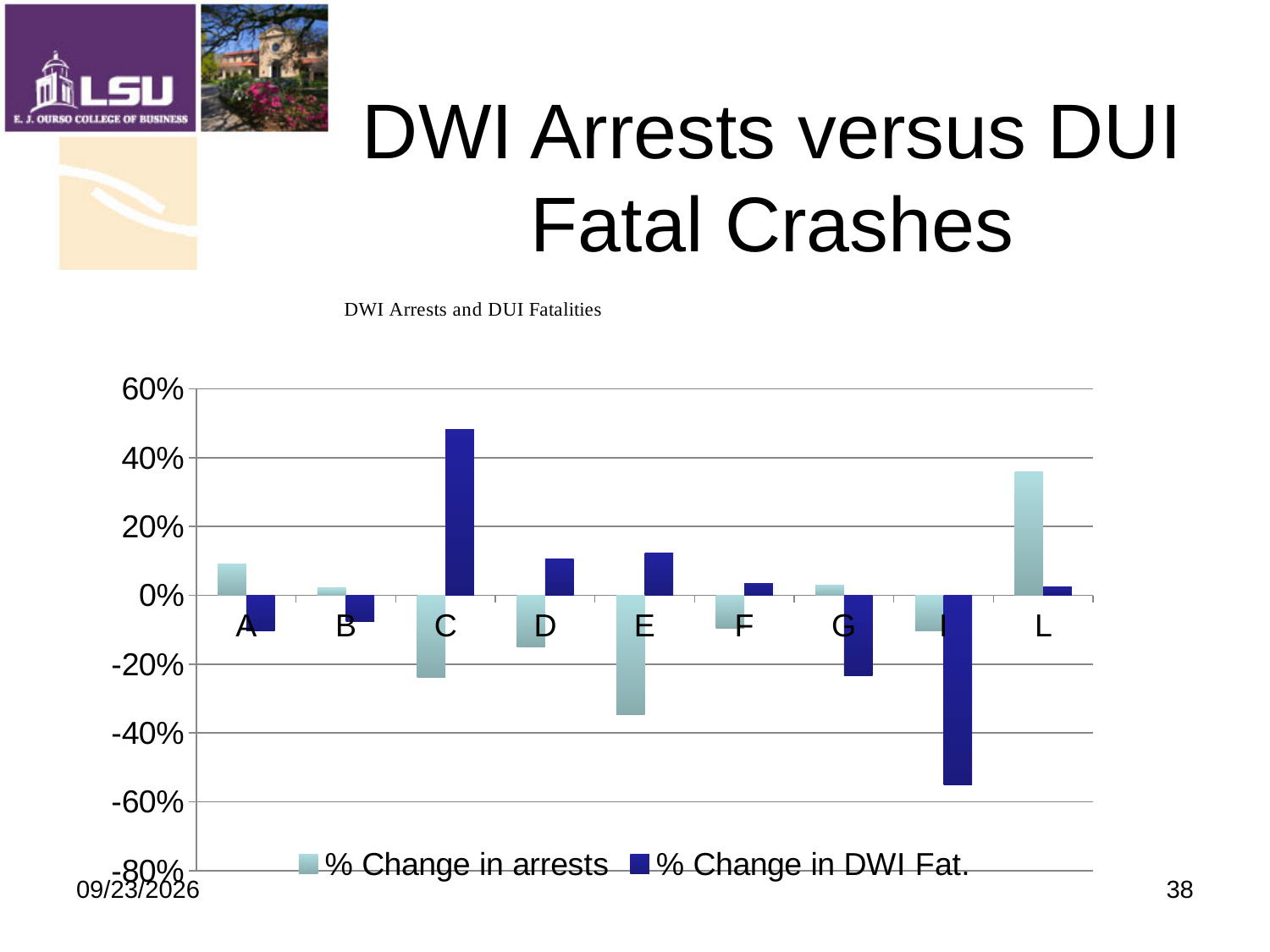
Which category has the lowest value for % Change in arrests? E Which category has the lowest value for % Change in DWI Fat.? I How many categories are shown on the x axis of the chart? 9 Is the value for % Change in DWI Fat. for category C greater or less than 40%? greater For category A, which series has the larger value: % Change in arrests or % Change in DWI Fat.? % Change in arrests Is the value for % Change in DWI Fat. for category I greater or less than -40%? less How many series does the chart's legend list? 2 Which category has the highest value for % Change in DWI Fat.? C What is the title printed above the chart? DWI Arrests and DUI Fatalities What kind of chart is shown on the slide? bar chart Is the value for % Change in arrests for category E greater or less than -20%? less Which category has the highest value for % Change in arrests? L